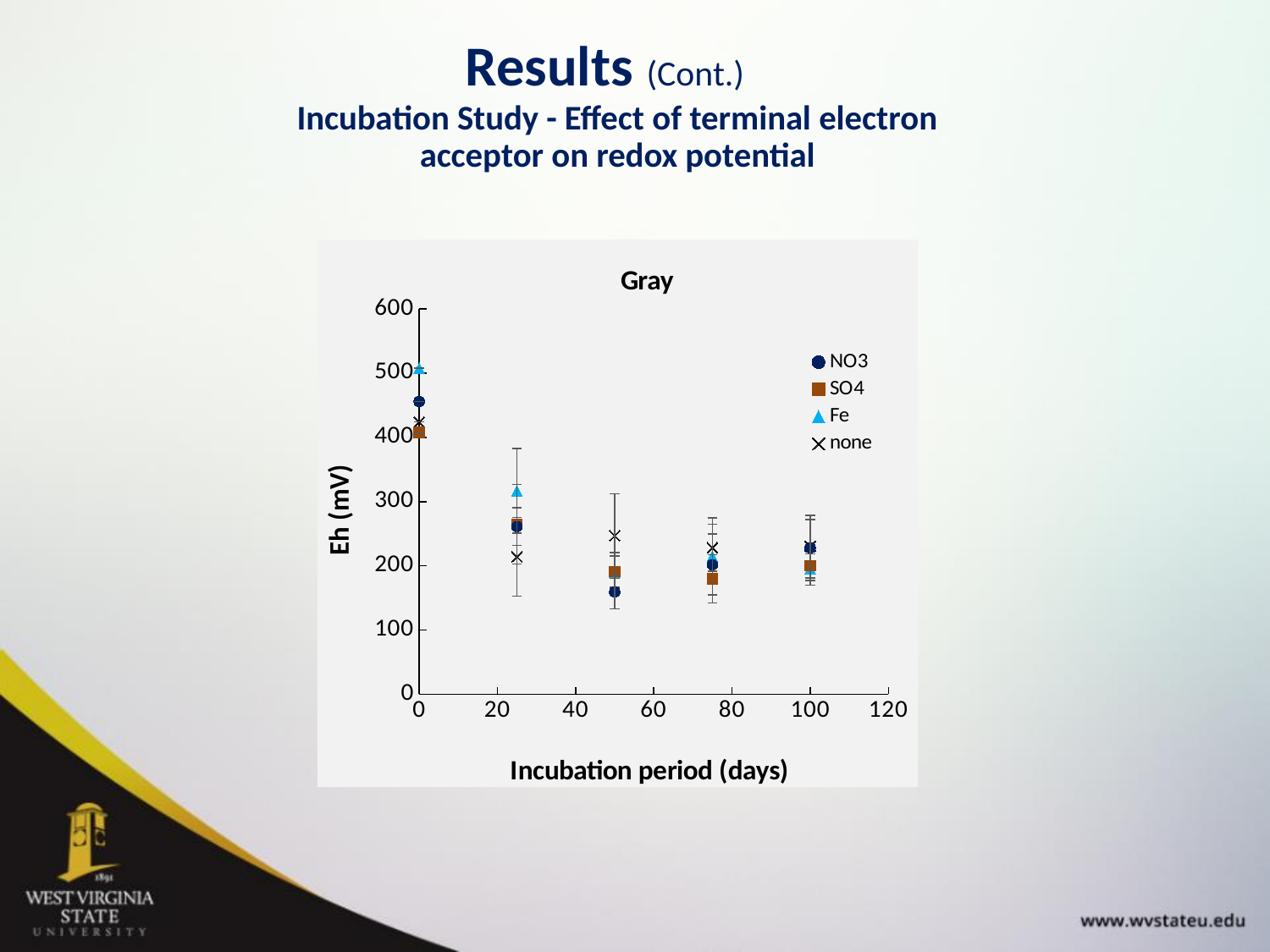
Which series has the lowest Eh value at day 50? NO3 Does the Eh value for NO3 rise or fall from day 0 to day 50? fall What kind of chart is shown on the slide? scatter chart What is the title of the chart? Gray Which series has the highest Eh value at day 25? Fe How many incubation time points are plotted for each series? 5 What is the label of the y axis of the chart? Eh (mV) How many series does the legend of the chart list? 4 Which series has the lowest Eh value at day 25? none Which series has the highest Eh value at day 0? Fe Is the Eh value for Fe at day 0 greater or less than 400? greater Is the Eh value for NO3 at day 50 greater or less than 200? less